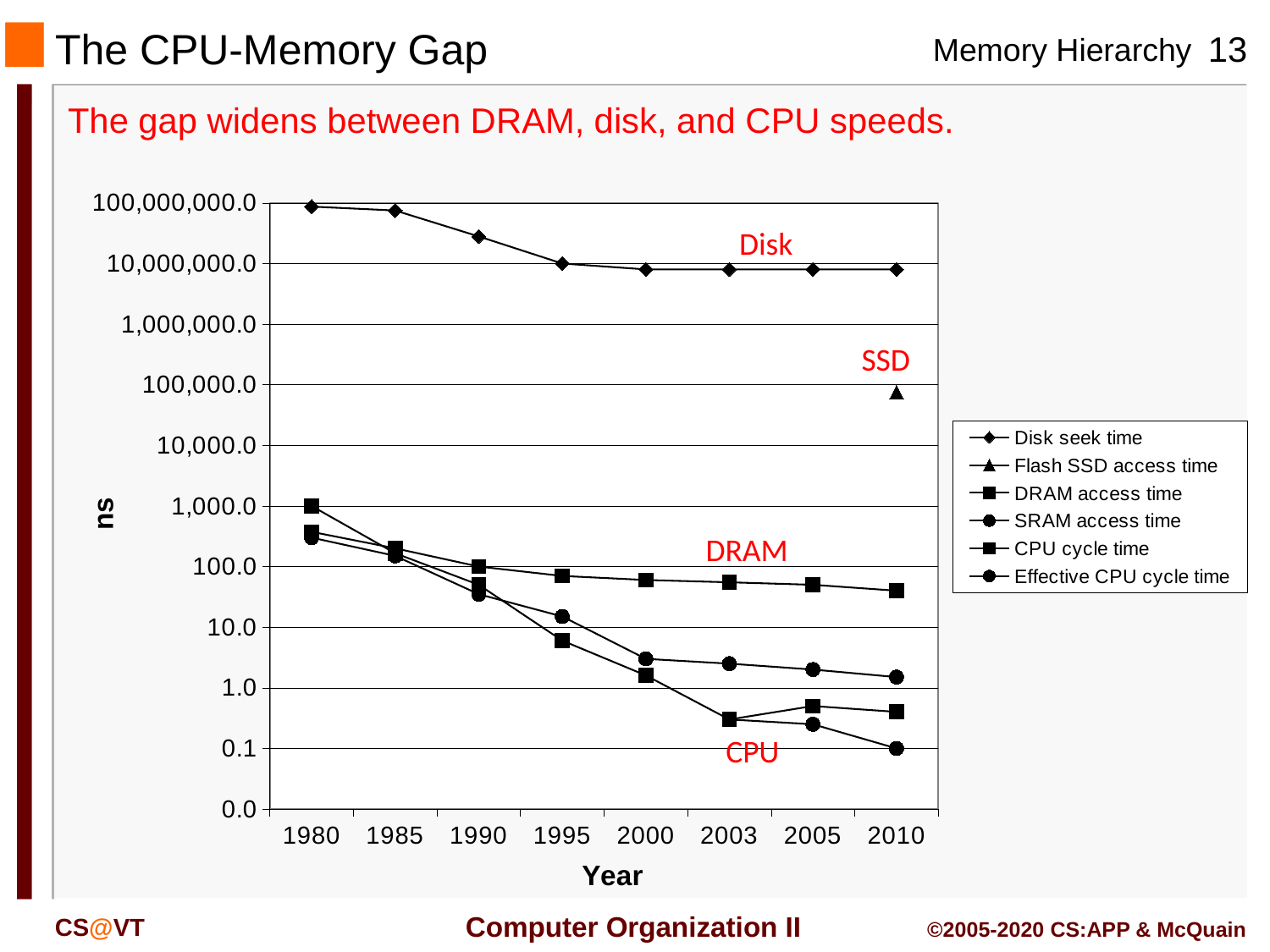
Is the DRAM access time value for 2010 greater or less than 100.0? less In 2010, which is larger: DRAM access time or SRAM access time? DRAM access time What kind of chart is shown on the slide? line chart Which series has the highest values on the chart? Disk seek time Is the Disk seek time value for 1980 greater or less than 10,000,000.0? greater Is the Effective CPU cycle time value for 2003 greater or less than 1.0? less What is the label on the x axis of the chart? Year How many years are marked along the x axis of the chart? 8 How many series does the chart's legend list? 6 What is the label on the y axis of the chart? ns Does the Disk seek time series rise or fall from 1980 to 2010? fall